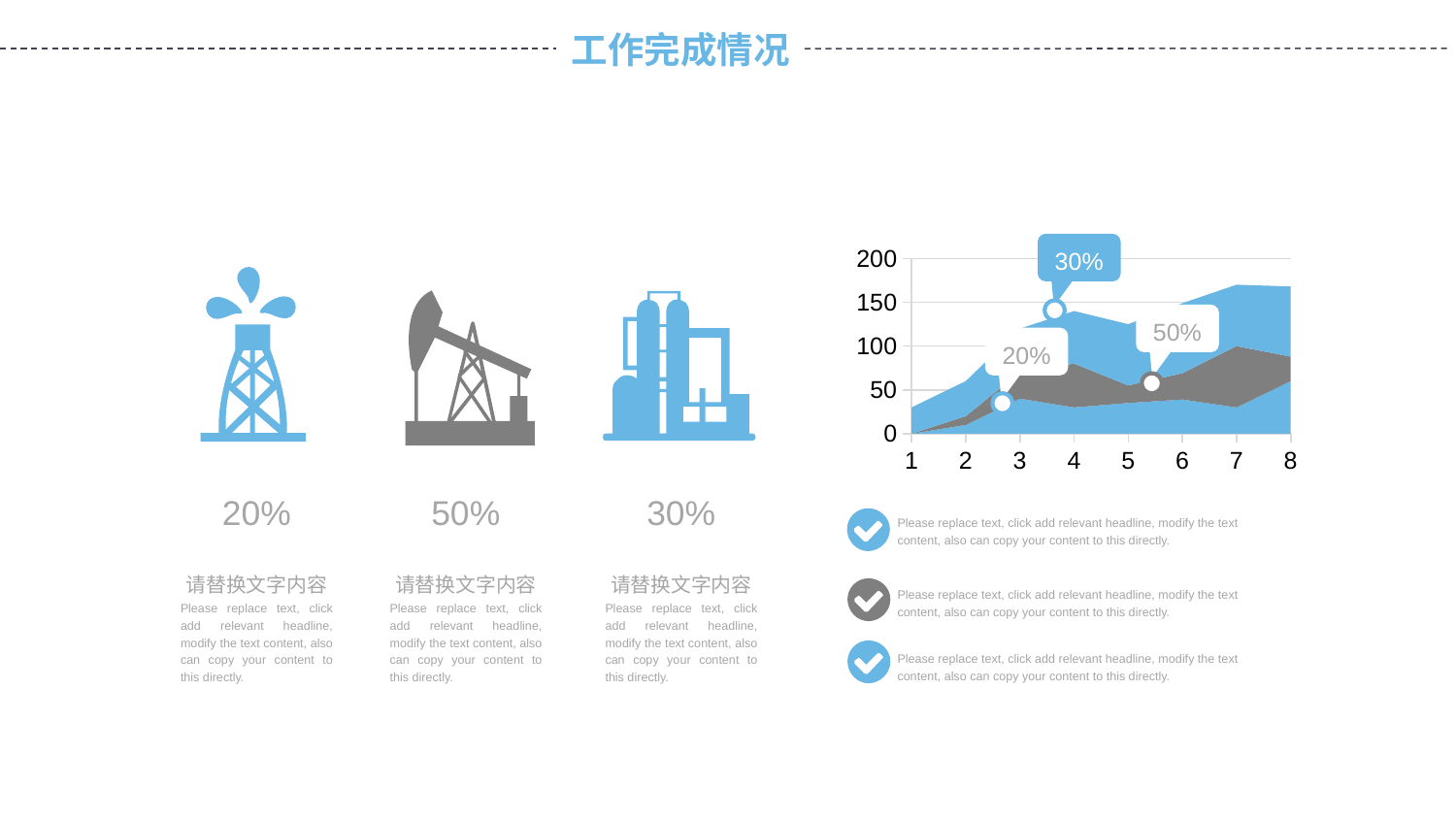
Does the blue area generally rise or fall from x = 1 to x = 4? rise Is the value of the grey area at x = 1 greater or less than 50? less Is the value of the blue area at x = 4 greater or less than 100? greater Which is larger at x = 4, the blue area or the grey area? blue area Is the value of the blue area at x = 1 greater or less than 50? less What kind of chart is shown on the right side of the slide? area chart How many points are labelled along the x axis of the chart? 8 What percentage is shown in the callout label above the marker at x = 4? 30% What is the highest value shown on the chart's y axis? 200 At which x-axis point is the blue area at its lowest? 1